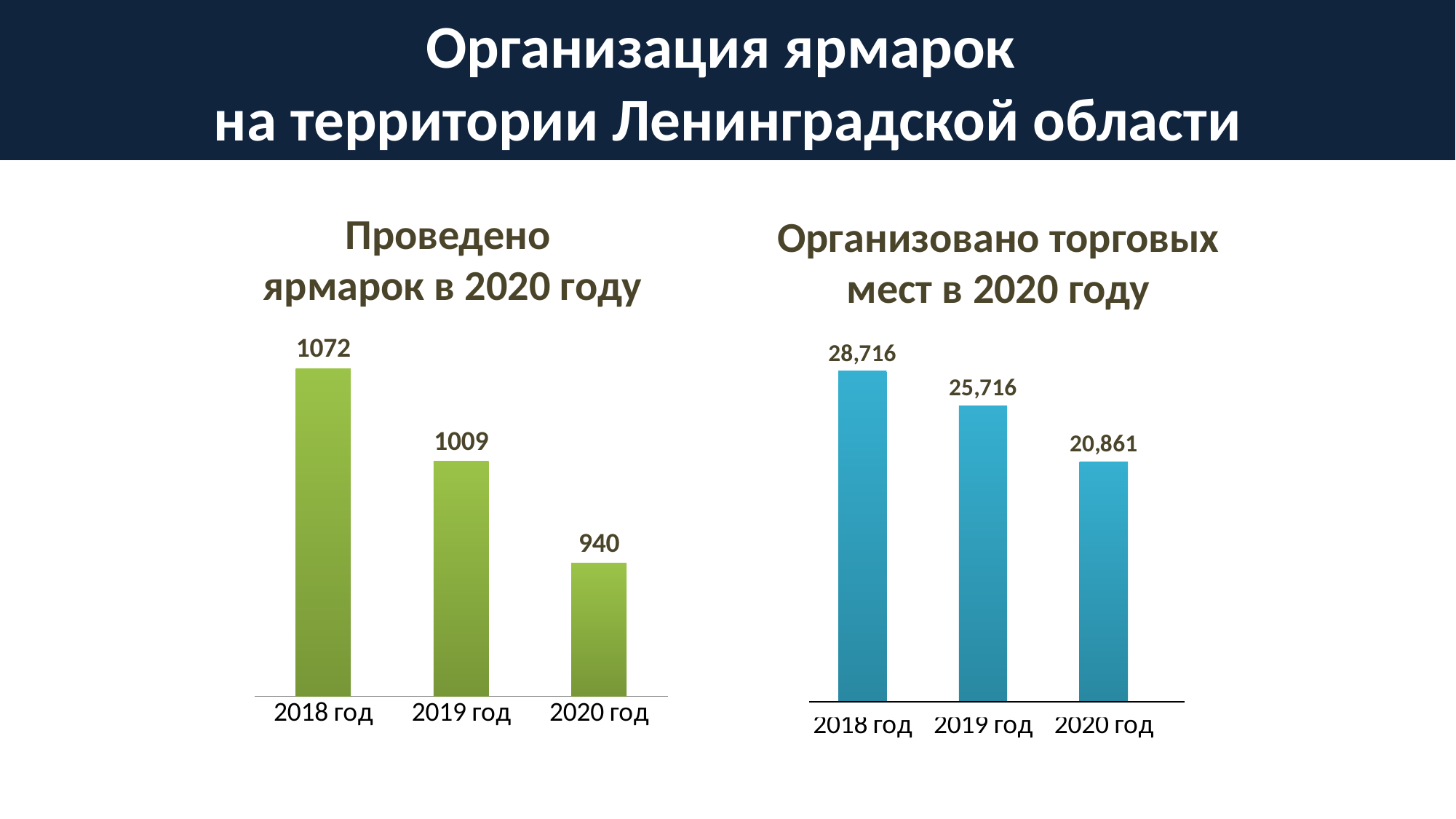
In the left chart 'Проведено ярмарок в 2020 году', do the values rise or fall from 2018 год to 2020 год? Fall In the left chart 'Проведено ярмарок в 2020 году', which year has the highest value? 2018 год In the left chart 'Проведено ярмарок в 2020 году', what is the value for 2018 год? 1072 In the right chart 'Организовано торговых мест в 2020 году', what is the difference between the values for 2018 год and 2019 год? 3,000 In the right chart 'Организовано торговых мест в 2020 году', which year has the lowest value? 2020 год In the right chart 'Организовано торговых мест в 2020 году', what is the value for 2020 год? 20,861 In the right chart 'Организовано торговых мест в 2020 году', what is the value for 2019 год? 25,716 How many bars are in the left chart 'Проведено ярмарок в 2020 году'? 3 In the left chart 'Проведено ярмарок в 2020 году', what is the difference between the values for 2018 год and 2020 год? 132 In the right chart 'Организовано торговых мест в 2020 году', which is larger, the value for 2018 год or 2020 год? 2018 год In the left chart 'Проведено ярмарок в 2020 году', what is the value for 2020 год? 940 What type of chart is the right chart 'Организовано торговых мест в 2020 году'? Bar chart